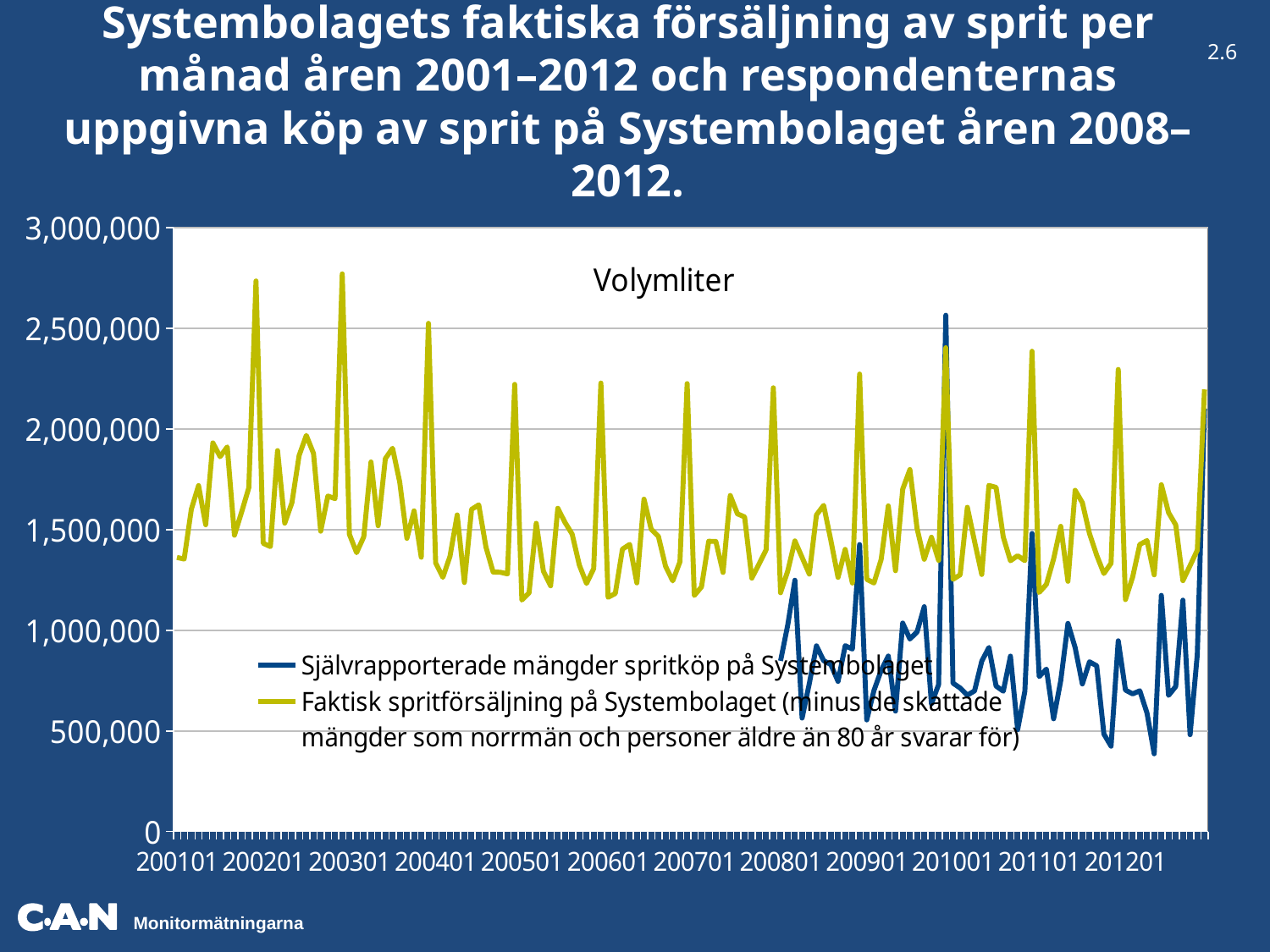
How many year labels are shown on the x axis? 12 Which series only has data from 2008 onwards? Självrapporterade mängder spritköp på Systembolaget What kind of chart is shown on the slide? line chart How many series does the legend list? 2 Which series generally has higher values, Självrapporterade mängder spritköp på Systembolaget or Faktisk spritförsäljning på Systembolaget? Faktisk spritförsäljning på Systembolaget Is the peak of the Självrapporterade mängder spritköp på Systembolaget series near 201001 greater or less than 2,000,000? greater What is the first series listed in the legend? Självrapporterade mängder spritköp på Systembolaget Is the value for Faktisk spritförsäljning på Systembolaget at 200101 greater or less than 1,000,000? greater What label is shown at the top of the plot area describing the unit of the values? Volymliter Is the lowest value of the Självrapporterade mängder spritköp på Systembolaget series greater or less than 500,000? less Do the annual peaks of the Faktisk spritförsäljning på Systembolaget series generally rise or fall from 2001 to 2012? fall